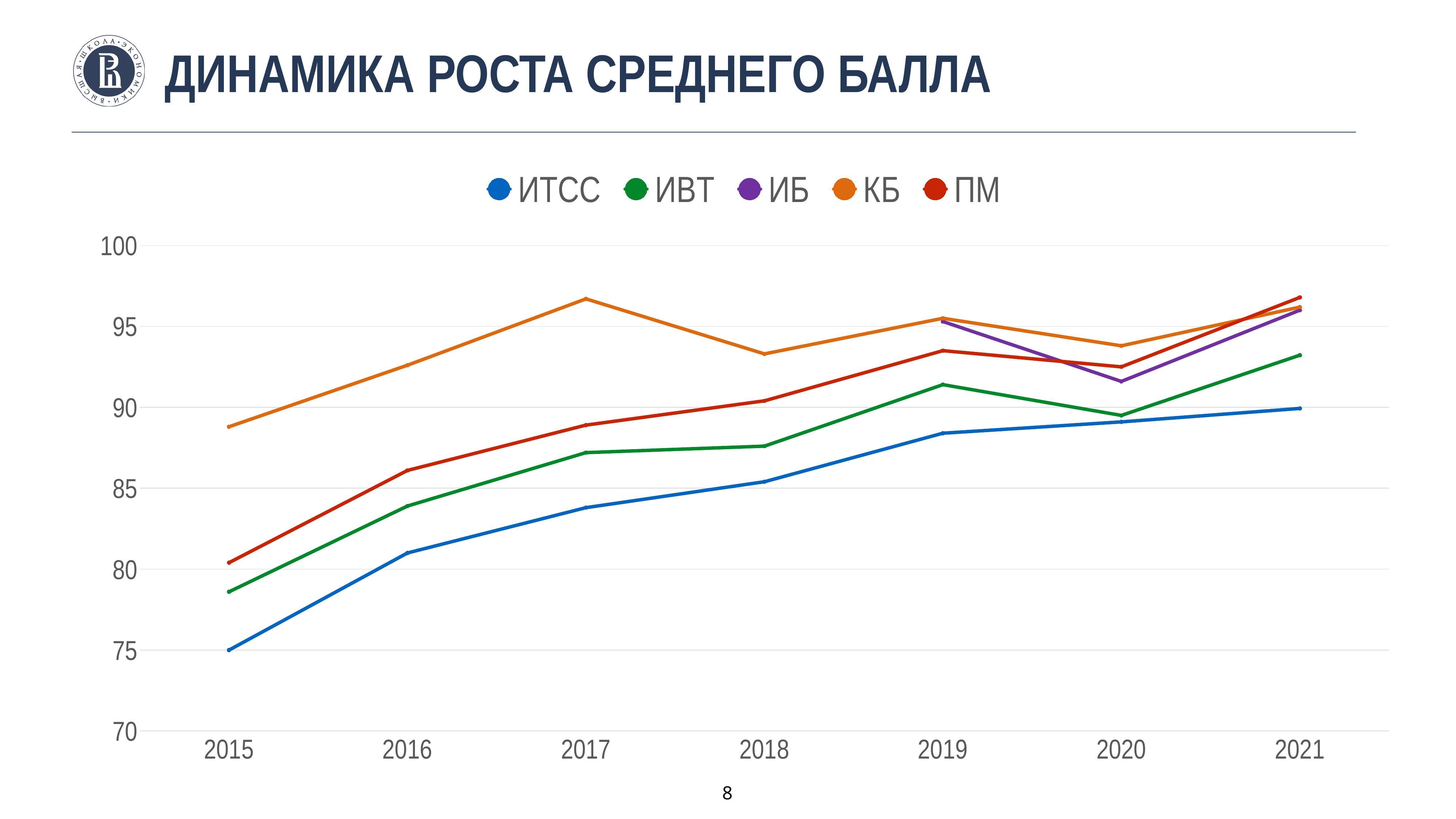
Which series has the lowest value in 2015? ИТСС What kind of chart is shown on the slide? line chart What is the title of the chart on the slide? ДИНАМИКА РОСТА СРЕДНЕГО БАЛЛА Which is larger in 2021, the value for ИТСС or the value for ИВТ? ИВТ Which series has the highest value in 2017? КБ Which series has the lowest value in 2021? ИТСС Does the ИТСС line rise or fall from 2015 to 2021? rises Is the value for ИТСС in 2015 greater or less than 80? less How many years are shown on the x axis? 7 Is the value for ИВТ in 2018 greater or less than 90? less How many series does the legend list? 5 Is the value for КБ in 2017 greater or less than 95? greater